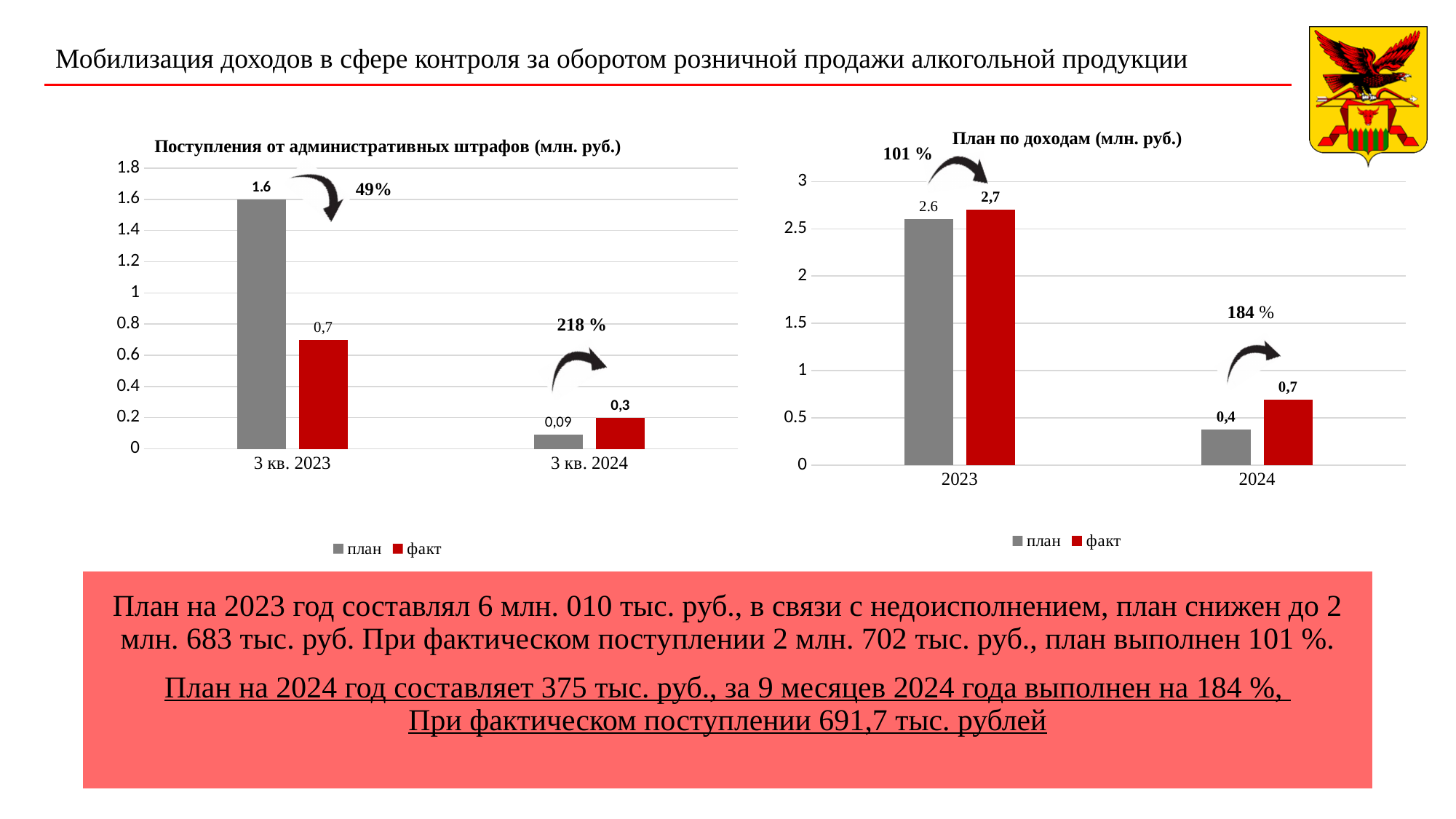
In the chart titled "План по доходам (млн. руб.)", is the value of план for 2023 greater or less than 2? greater What kind of chart is the chart titled "План по доходам (млн. руб.)"? bar chart In the chart titled "План по доходам (млн. руб.)", what is the value of план for 2024? 0,4 In the chart titled "План по доходам (млн. руб.)", what colour are the факт bars? red In the chart titled "План по доходам (млн. руб.)", which is larger for 2023, план or факт? факт In the chart titled "Поступления от административных штрафов (млн. руб.)", what is the value of план for 3 кв. 2024? 0,09 In the chart titled "Поступления от административных штрафов (млн. руб.)", what is the value of план for 3 кв. 2023? 1.6 In the chart titled "Поступления от административных штрафов (млн. руб.)", what is the value of факт for 3 кв. 2024? 0,3 In the chart titled "Поступления от административных штрафов (млн. руб.)", how many series does the legend list? 2 In the chart titled "Поступления от административных штрафов (млн. руб.)", which bar is the highest? план, 3 кв. 2023 In the chart titled "План по доходам (млн. руб.)", what is the difference between факт and план for 2024? 0,3 In the chart titled "План по доходам (млн. руб.)", what is the value of факт for 2023? 2,7